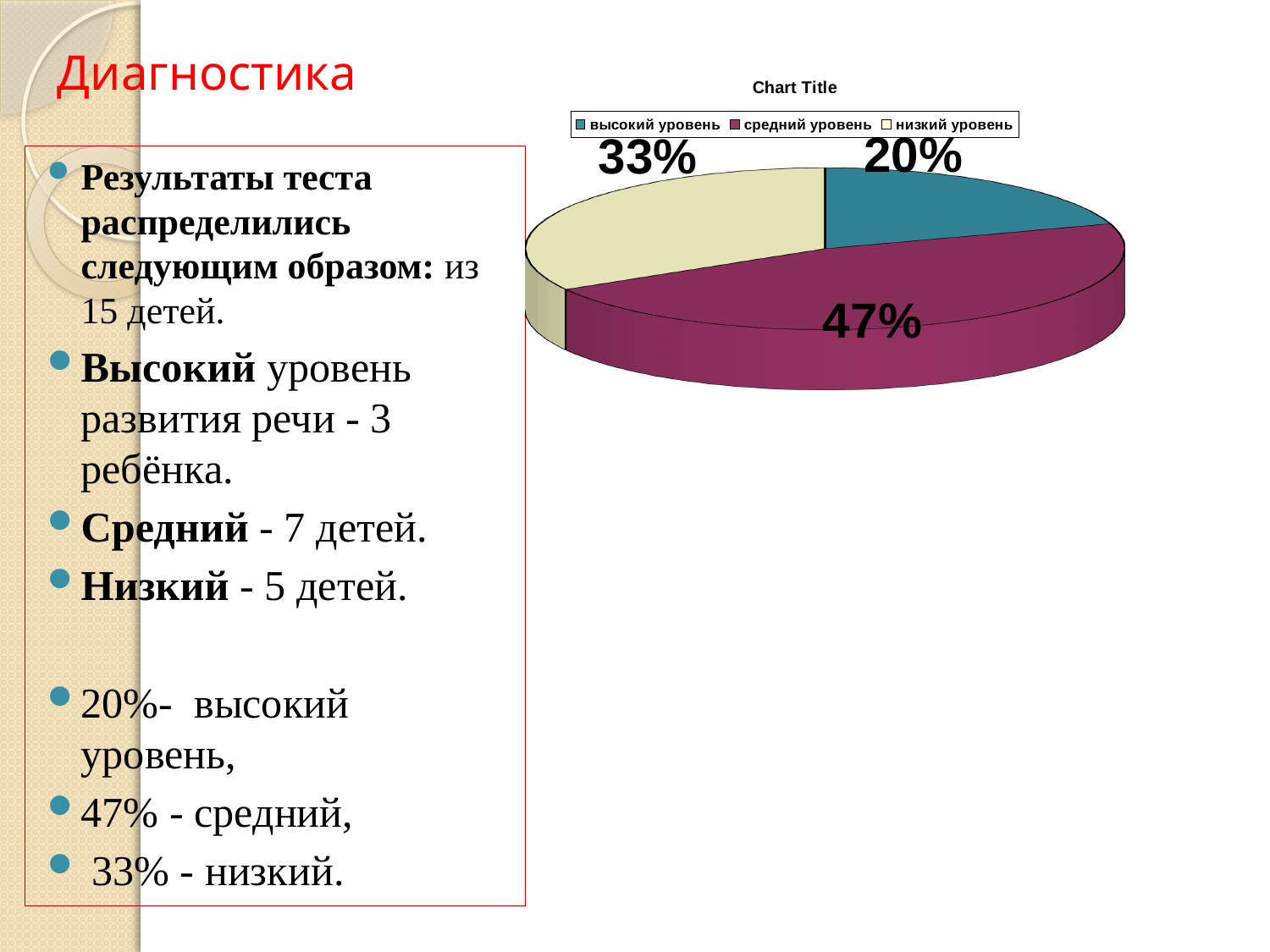
What kind of chart is shown on the slide? pie chart How many slices does the pie chart have? 3 What share of the pie does "высокий уровень" have? 20% What colour is the slice for "средний уровень"? magenta (purple-red) Which category has the largest slice of the pie? средний уровень What share of the pie does "средний уровень" have? 47% What is the difference in percentage points between "средний уровень" and "низкий уровень"? 14 Which is larger, the slice for "низкий уровень" or the slice for "высокий уровень"? низкий уровень What is the title shown above the pie chart? Chart Title How many entries does the legend list? 3 Which category has the smallest slice of the pie? высокий уровень What share of the pie does "низкий уровень" have? 33%